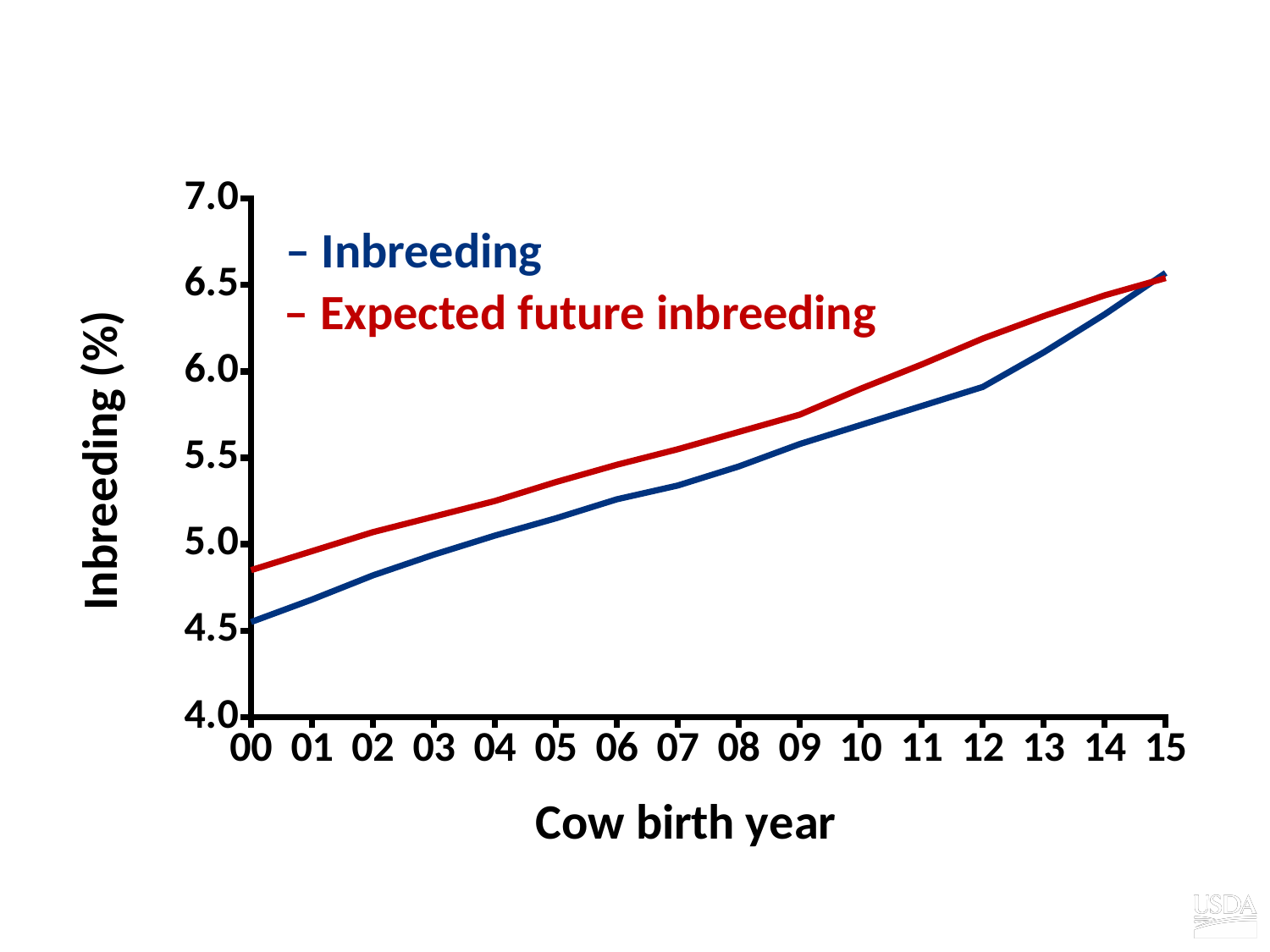
Is the Inbreeding value for cow birth year 15 greater or less than 6.0? greater Does the Inbreeding line rise or fall from birth year 00 to 15? rise In which cow birth year is Expected future inbreeding lowest? 00 What kind of chart is shown on the slide? line chart At cow birth year 00, which is larger: Inbreeding or Expected future inbreeding? Expected future inbreeding How many cow birth years are plotted along the x axis? 16 Is the Inbreeding value for cow birth year 00 greater or less than 5.0? less Does the Expected future inbreeding line rise or fall across the cow birth years? rise What is the label of the y axis? Inbreeding (%) At cow birth year 12, which is larger: Inbreeding or Expected future inbreeding? Expected future inbreeding How many series does the legend list? 2 In which cow birth year is Inbreeding highest? 15